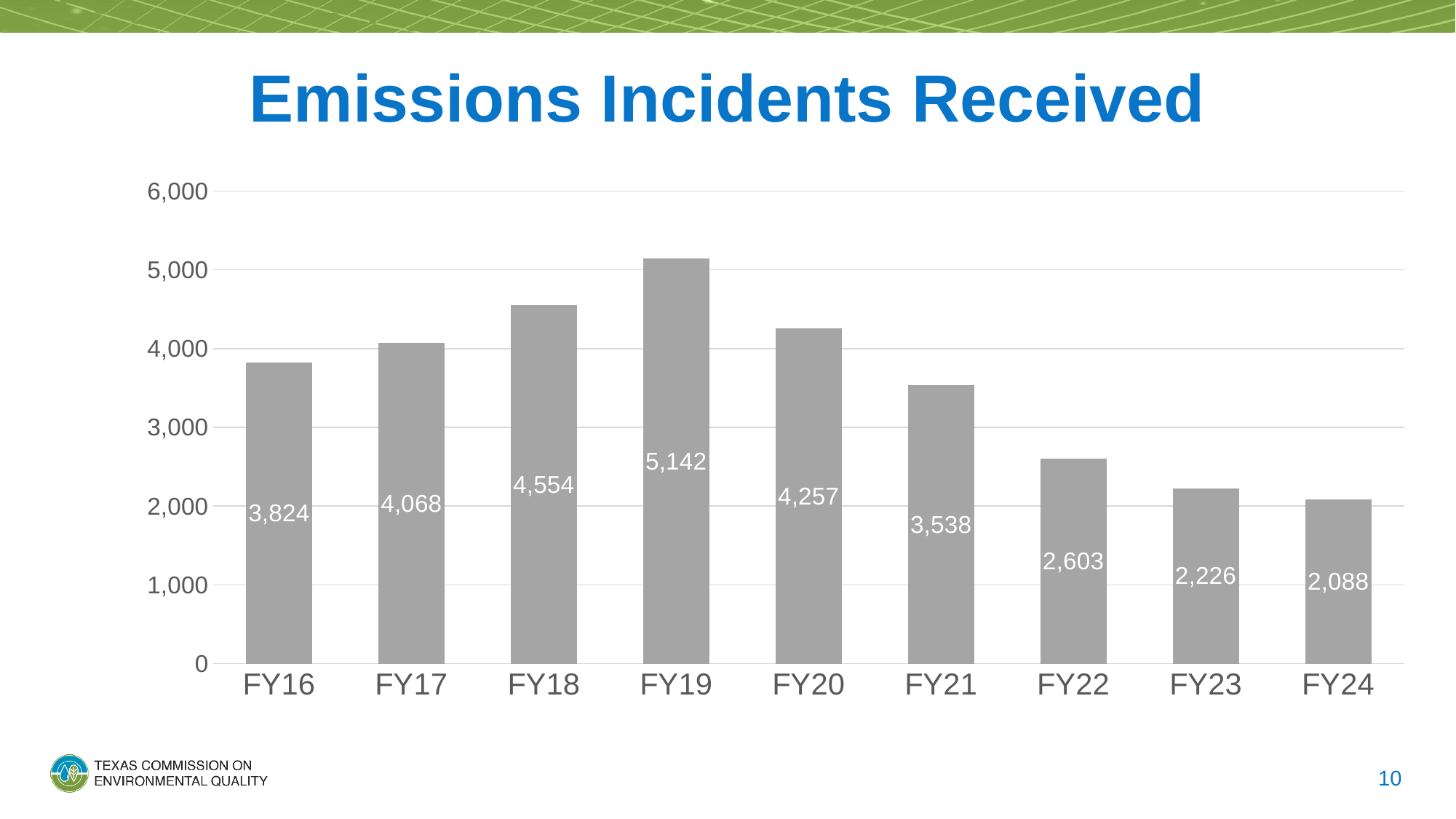
Is the value for FY22 greater or less than 3,000? less What is the difference between the values for FY19 and FY24? 3,054 Which fiscal year has the highest number of emissions incidents received? FY19 What is the value for FY24? 2,088 How many fiscal years are shown on the x axis? 9 What kind of chart is shown on the slide? bar chart Which is larger, the value for FY16 or the value for FY20? FY20 What is the difference between the values for FY18 and FY17? 486 What is the value for FY19? 5,142 Do the values rise or fall from FY19 to FY24? fall Which fiscal year has the lowest number of emissions incidents received? FY24 What is the value for FY21? 3,538